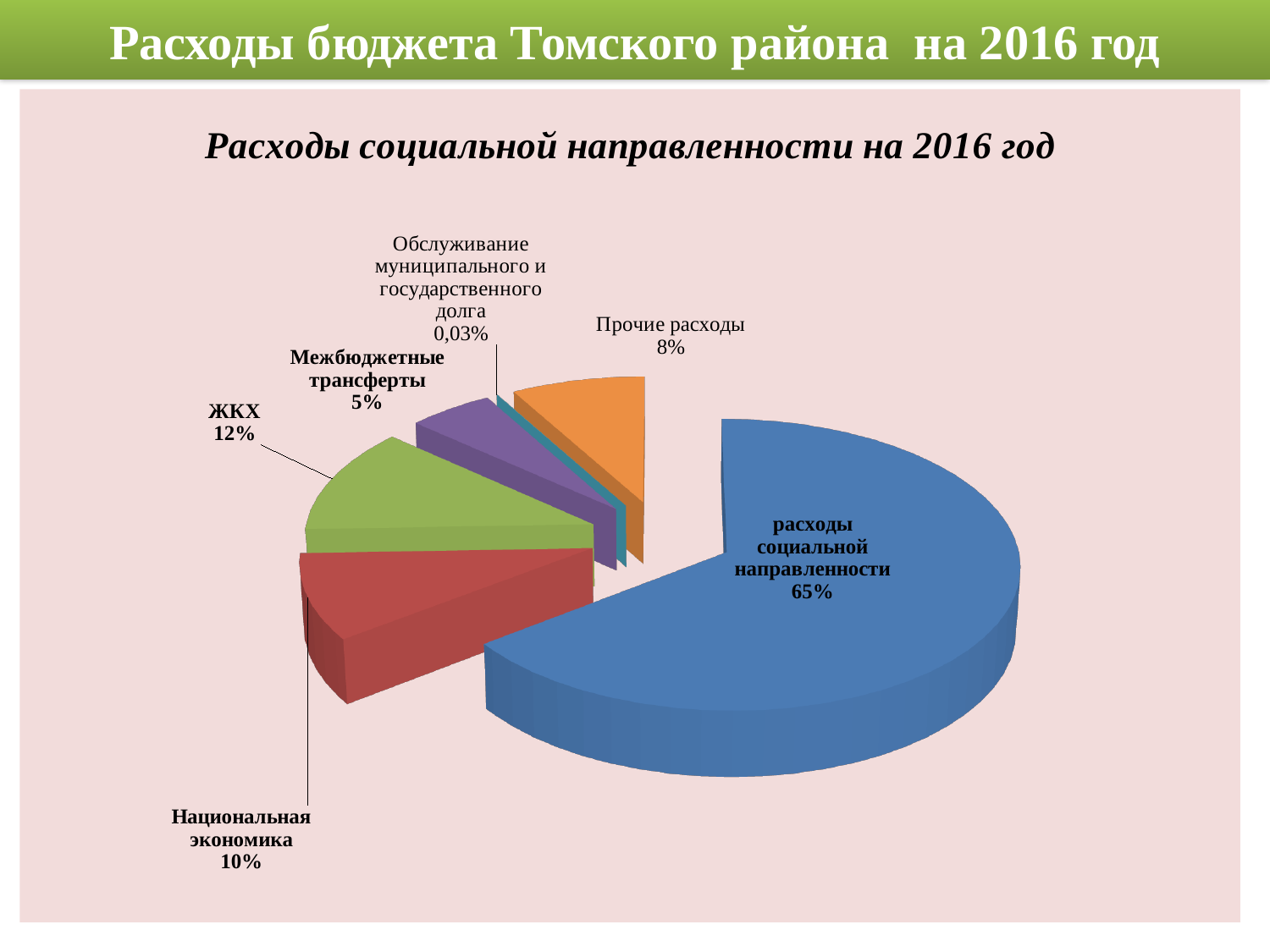
Which category has the smallest slice of the pie? Обслуживание муниципального и государственного долга What is the value shown for "Национальная экономика"? 10% What is the value shown for "Межбюджетные трансферты"? 5% How many slices does the pie chart have? 6 What is the value shown for "Обслуживание муниципального и государственного долга"? 0,03% What share of the pie does "расходы социальной направленности" have? 65% Which is larger, "Прочие расходы" or "Межбюджетные трансферты"? Прочие расходы Which category has the largest slice of the pie? расходы социальной направленности What is the value shown for "ЖКХ"? 12% What is the value shown for "Прочие расходы"? 8% What is the difference in percentage points between "ЖКХ" and "Национальная экономика"? 2% What type of chart is shown on the slide? pie chart